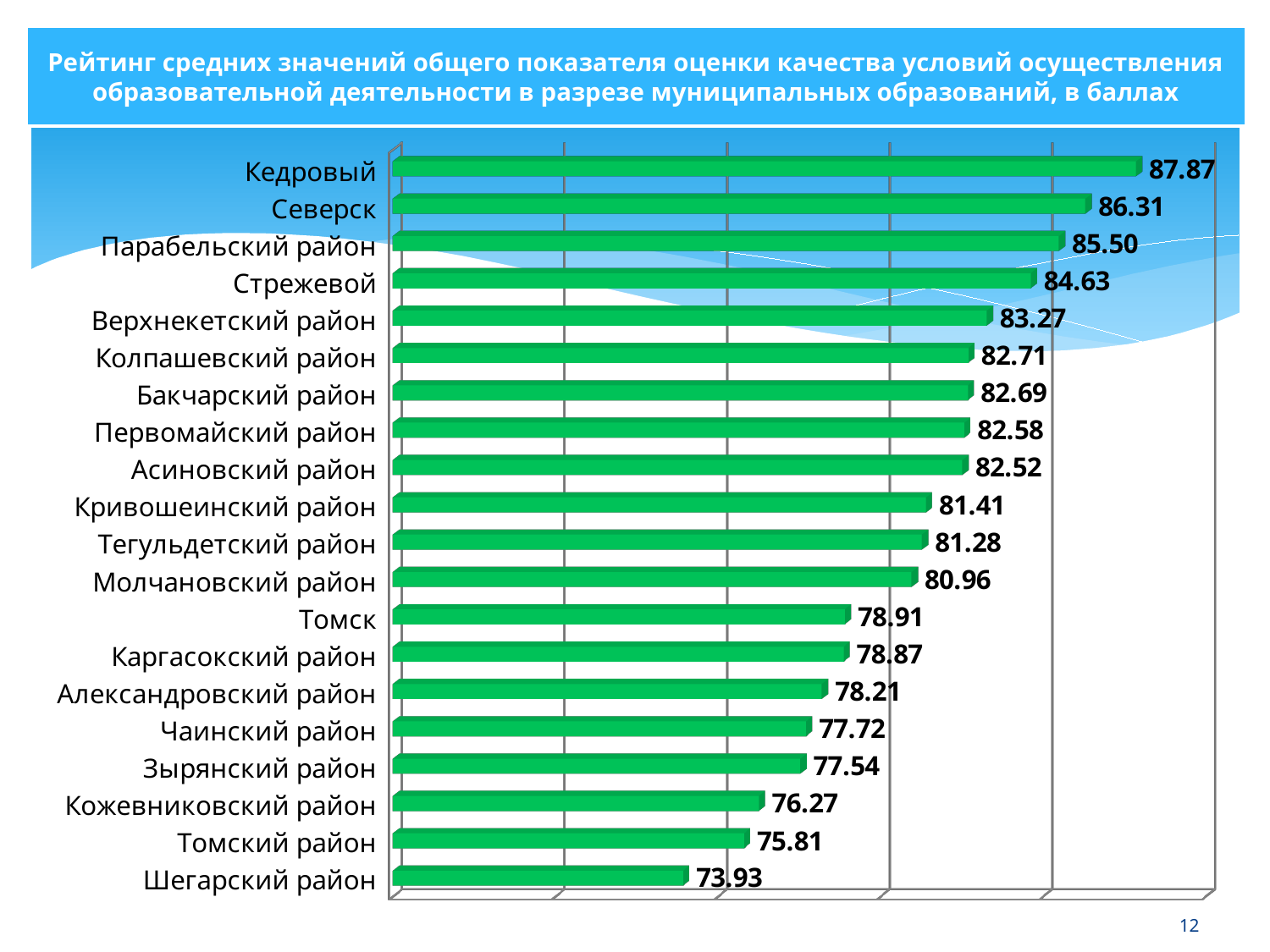
How many categories are shown in the chart? 20 What is the value for Кожевниковский район? 76.27 What is the value for Молчановский район? 80.96 Which category has the highest value? Кедровый What colour are the bars in the chart? Green What is the value for Томск? 78.91 Which category has the lowest value? Шегарский район What is the difference between the values for Кедровый and Шегарский район? 13.94 Which has a larger value, Стрежевой or Томск? Стрежевой What is the difference between the values for Северск and Парабельский район? 0.81 What kind of chart is shown on the slide? Bar chart What is the value for Кедровый? 87.87